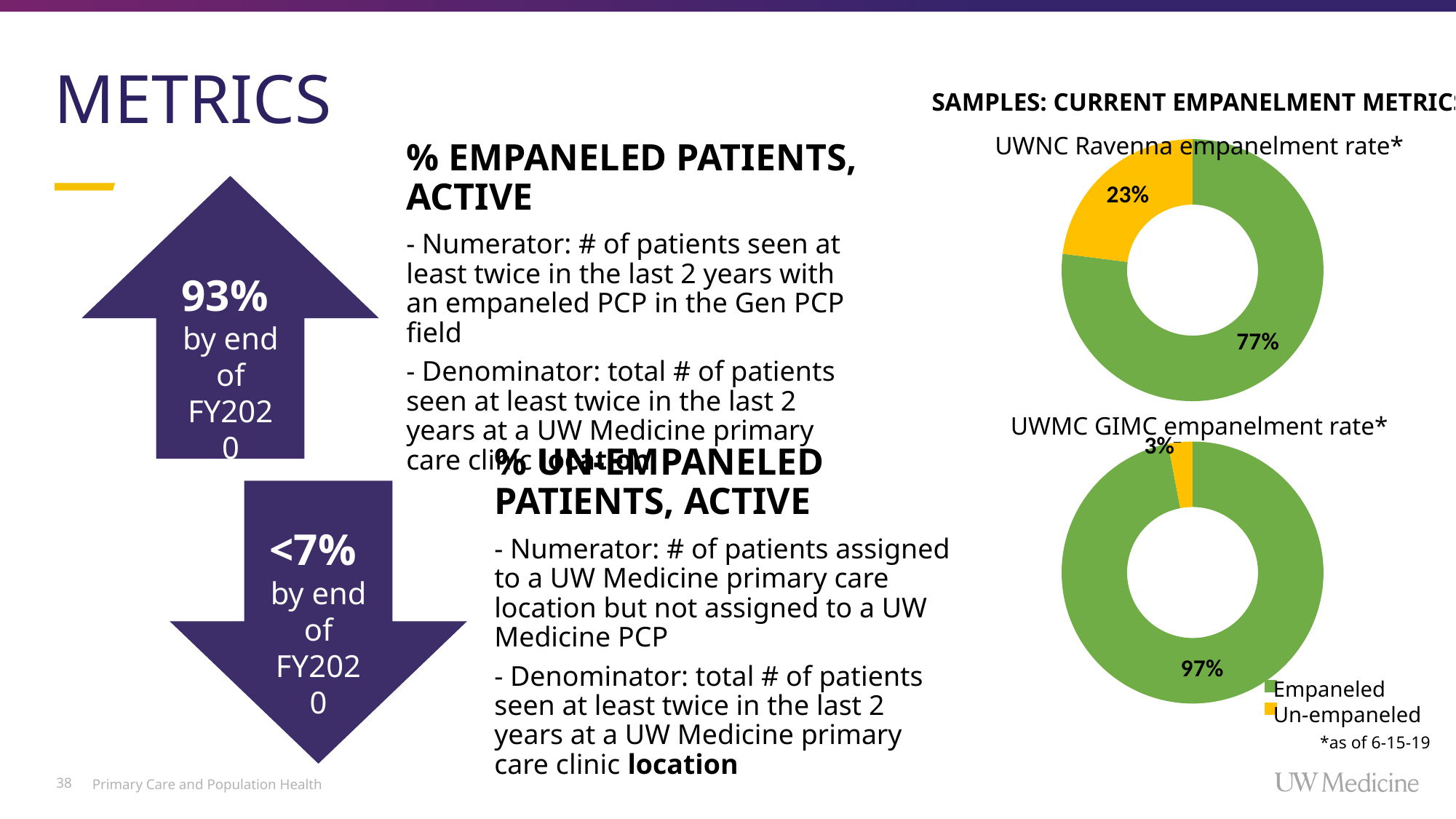
In the 'UWNC Ravenna empanelment rate*' chart, what percentage of patients are empaneled? 77% In the 'UWNC Ravenna empanelment rate*' chart, which slice is the largest? Empaneled In the 'UWMC GIMC empanelment rate*' chart, which slice is the smallest? Un-empaneled In the 'UWNC Ravenna empanelment rate*' chart, what percentage of patients are un-empaneled? 23% In the 'UWNC Ravenna empanelment rate*' chart, what is the difference between the empaneled and un-empaneled percentages? 54% How many entries does the legend list for the empanelment rate charts? 2 In the 'UWMC GIMC empanelment rate*' chart, what percentage of patients are empaneled? 97% Which chart shows a higher empaneled percentage, 'UWNC Ravenna empanelment rate*' or 'UWMC GIMC empanelment rate*'? UWMC GIMC empanelment rate* What type of chart is the 'UWNC Ravenna empanelment rate*' chart? Doughnut chart In the 'UWMC GIMC empanelment rate*' chart, what percentage of patients are un-empaneled? 3% How many slices does the 'UWMC GIMC empanelment rate*' chart have? 2 In the empanelment rate charts, what colour represents the 'Un-empaneled' slice? Yellow